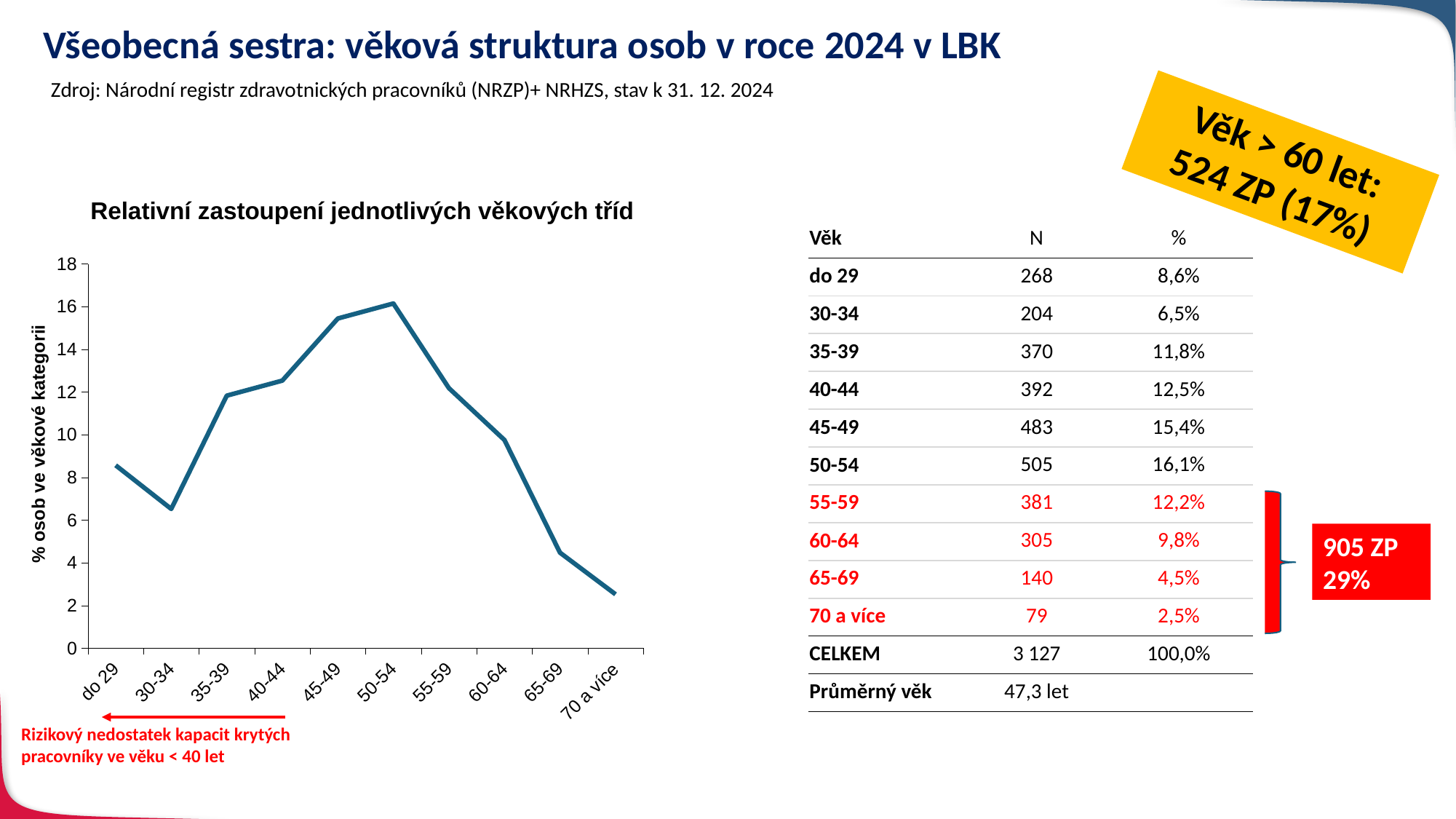
What is the title of the chart? Relativní zastoupení jednotlivých věkových tříd How many age categories are plotted along the x axis of the chart? 10 What kind of chart is shown on the slide? line chart Is the value for 70 a více greater or less than 4? less Do the values rise or fall along the x axis from 50-54 to 70 a více? fall Which age category has the lowest value in the chart? 70 a více Which is larger, the value for 35-39 or the value for 60-64? 35-39 What is the label of the chart's vertical axis? % osob ve věkové kategorii Is the value for 45-49 greater or less than 14? greater Is the value for 65-69 greater or less than 6? less Which age category has the highest value in the chart? 50-54